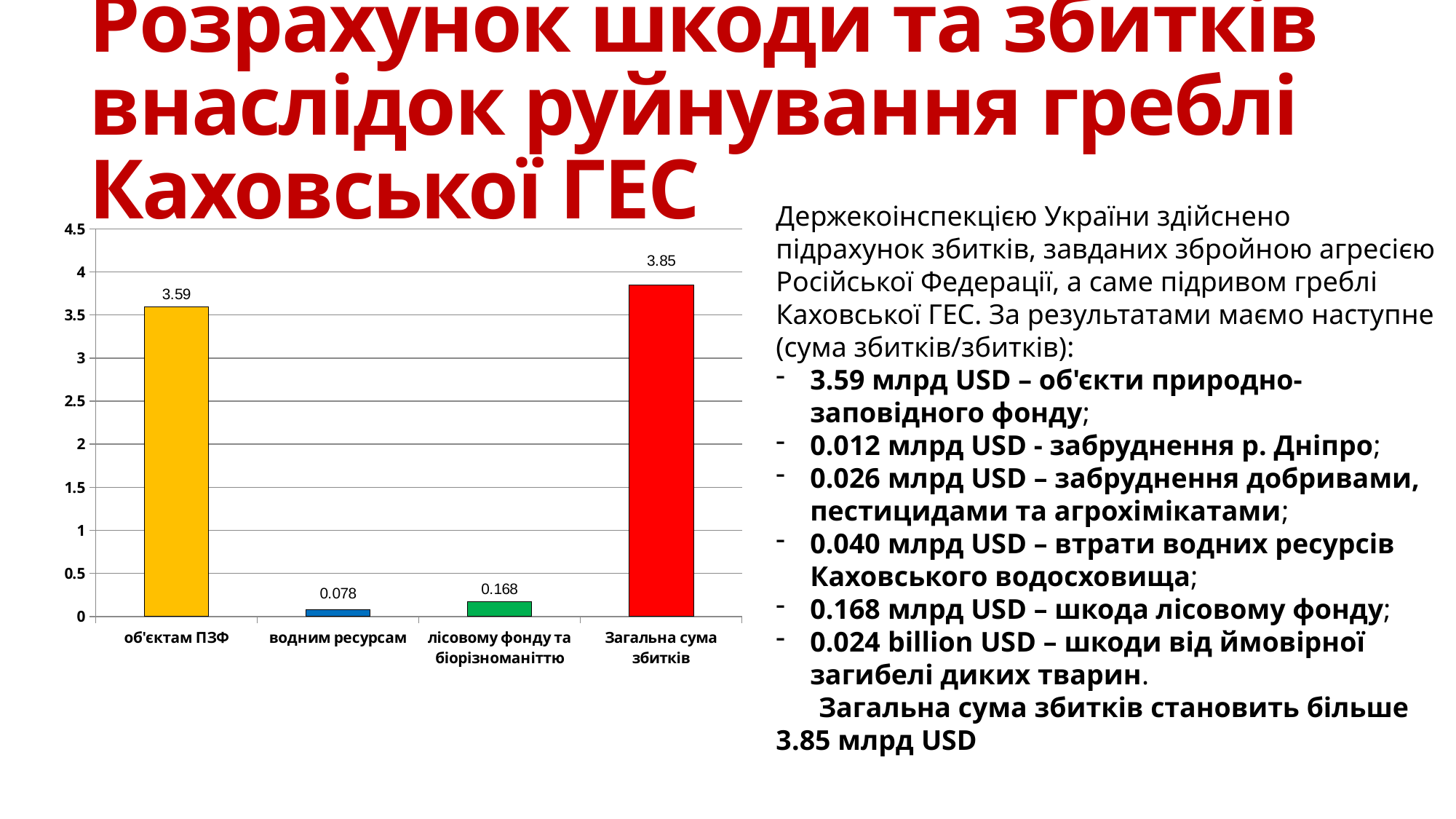
What is the value shown for Загальна сума збитків? 3.85 What is the value shown for об'єктам ПЗФ? 3.59 Which is larger, the value for лісовому фонду та біорізноманіттю or the value for водним ресурсам? лісовому фонду та біорізноманіттю How many categories are shown on the x axis of the chart? 4 What kind of chart is shown on the slide? bar chart What colour is the bar for Загальна сума збитків? red Which category has the lowest value? водним ресурсам What is the value shown for водним ресурсам? 0.078 Is the value for об'єктам ПЗФ greater or less than 3? greater What is the difference between the values for Загальна сума збитків and об'єктам ПЗФ? 0.26 Which category has the highest value? Загальна сума збитків What is the value shown for лісовому фонду та біорізноманіттю? 0.168